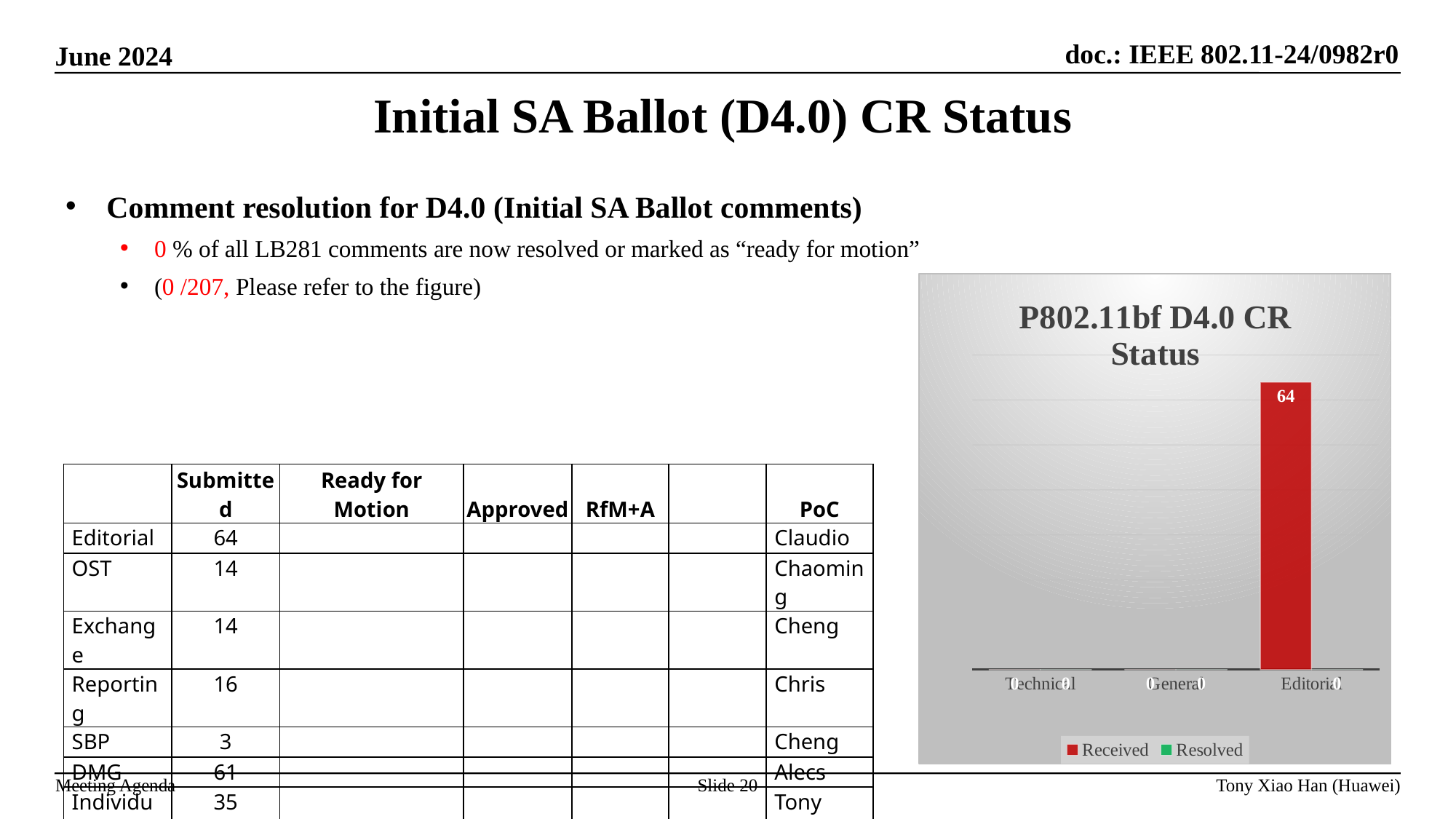
What is the Received value for General in the chart? 0 What is the title of the chart on the slide? P802.11bf D4.0 CR Status What is the difference between the Received values for Editorial and General in the chart? 64 How many categories are shown on the x axis of the chart? 3 What kind of chart is shown on the slide? bar chart What is the Received value for Technical in the chart? 0 Which is larger in the chart: the Received value for Editorial or the Received value for Technical? Editorial Which category has the highest Received value in the chart? Editorial Is the Received value for Editorial greater or less than 50? greater How many series does the chart legend list? 2 Which series are listed in the chart legend? Received, Resolved What is the Received value for Editorial in the chart? 64